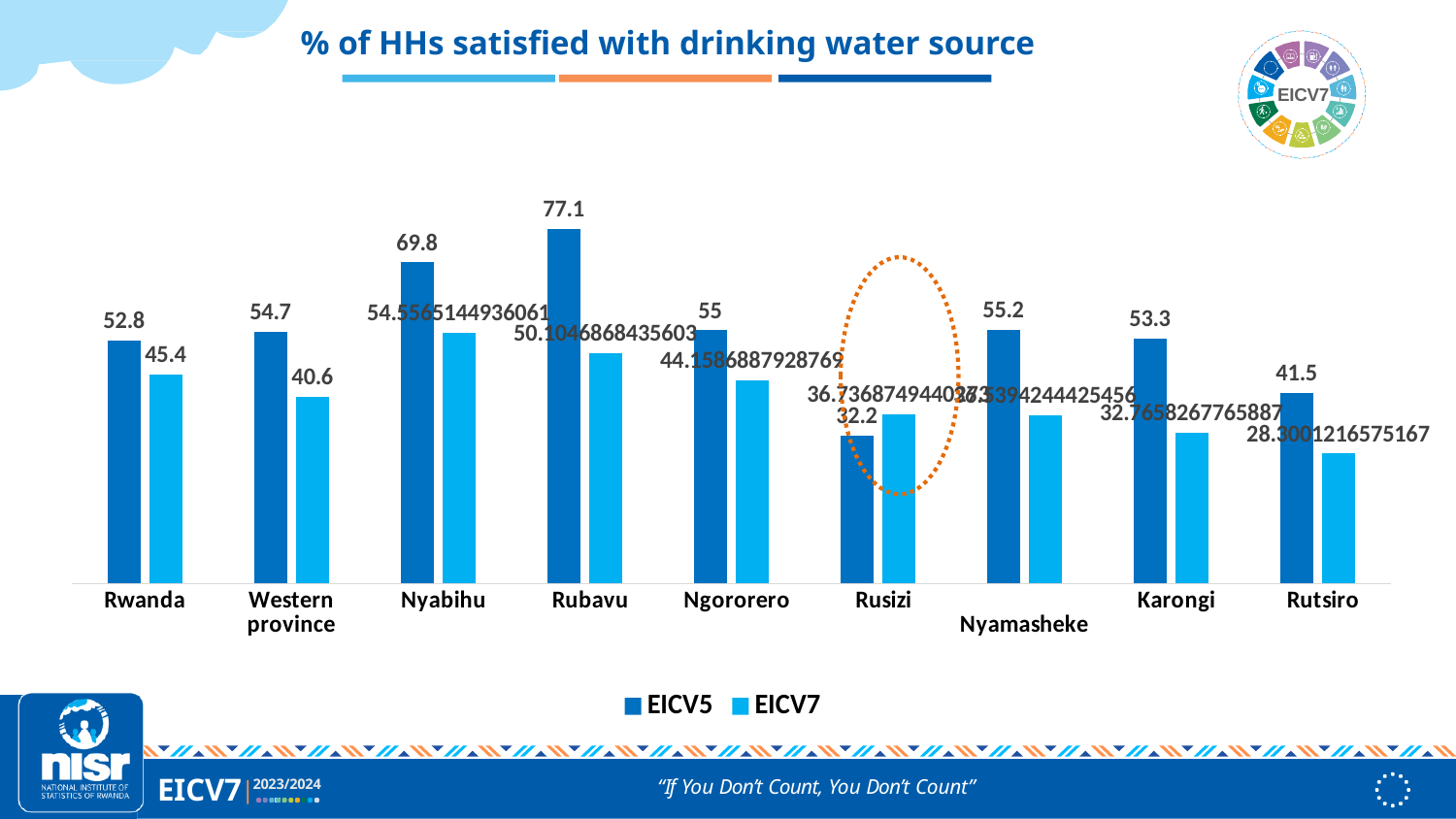
Which category has the lowest EICV5 value? Rusizi What is the EICV7 value for Western province? 40.6 How many categories are shown on the x axis? 9 What is the difference between the EICV5 and EICV7 values for Rwanda? 7.4 What kind of chart is shown on the slide? bar chart Which category has the lowest EICV7 value? Rutsiro What is the title of the chart? % of HHs satisfied with drinking water source Which category has the highest EICV5 value? Rubavu For Rusizi, which is larger: the EICV5 value or the EICV7 value? EICV7 How many series does the legend list? 2 What is the EICV5 value for Rwanda? 52.8 What is the EICV5 value for Nyamasheke? 55.2